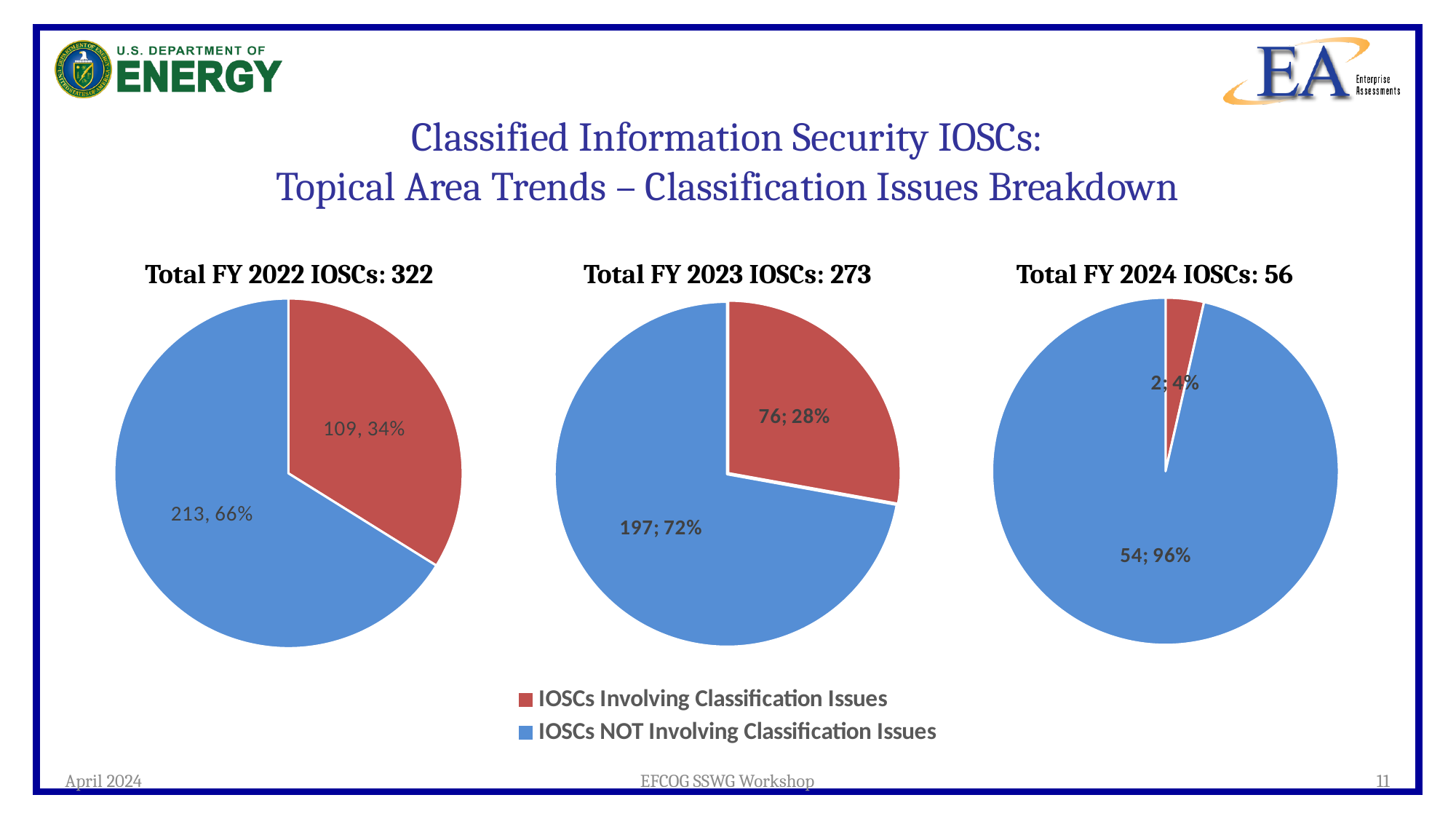
How many series does the legend list? 2 In the 'Total FY 2022 IOSCs: 322' pie chart, how many IOSCs involved classification issues? 109 Across the three pie charts, does the share of IOSCs involving classification issues rise or fall from FY 2022 to FY 2024? Fall How many pie charts are shown on the slide? 3 In the 'Total FY 2023 IOSCs: 273' pie chart, what is the difference between the number of IOSCs not involving classification issues and those involving classification issues? 121 In the 'Total FY 2022 IOSCs: 322' pie chart, what share of IOSCs involved classification issues? 34% What type of chart is used on this slide? Pie chart In the 'Total FY 2023 IOSCs: 273' pie chart, what percentage of IOSCs did NOT involve classification issues? 72% In the 'Total FY 2024 IOSCs: 56' pie chart, how many IOSCs involved classification issues? 2 Which colour represents IOSCs Involving Classification Issues in the legend? Red In the 'Total FY 2024 IOSCs: 56' pie chart, which slice is larger: IOSCs involving classification issues or IOSCs NOT involving classification issues? IOSCs NOT Involving Classification Issues In the 'Total FY 2022 IOSCs: 322' pie chart, how many IOSCs did NOT involve classification issues? 213